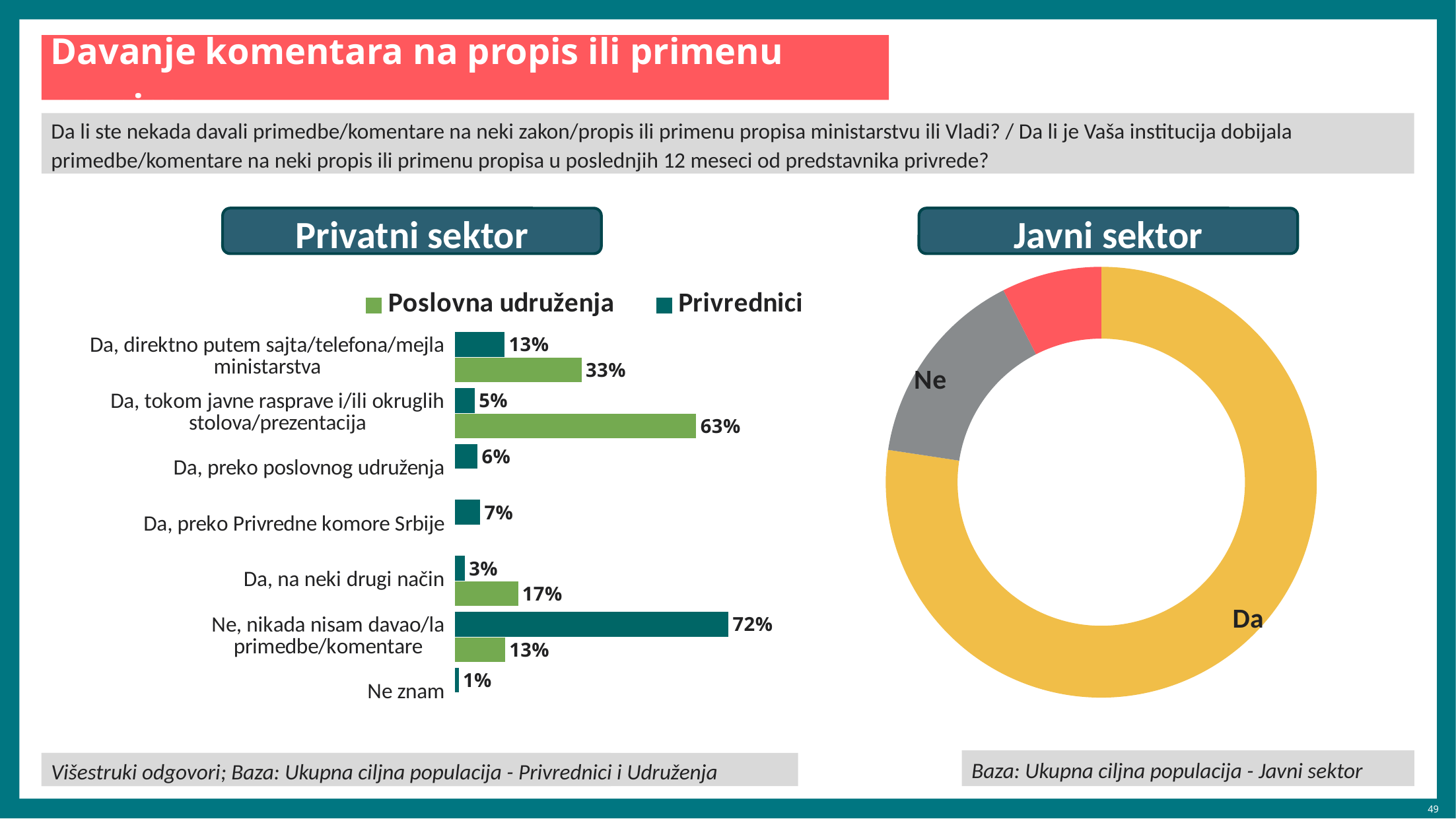
In the 'Privatni sektor' chart, which category has the highest value for Poslovna udruženja? Da, tokom javne rasprave i/ili okruglih stolova/prezentacija How many series does the legend of the 'Privatni sektor' chart list? 2 In the 'Privatni sektor' chart, what is the value for Privrednici for 'Ne, nikada nisam davao/la primedbe/komentare'? 72% What kind of chart is the 'Privatni sektor' chart? Bar chart In the 'Privatni sektor' chart, for 'Da, na neki drugi način', which series has the larger value: Poslovna udruženja or Privrednici? Poslovna udruženja In the 'Privatni sektor' chart, which category has the lowest value for Privrednici? Ne znam In the 'Privatni sektor' chart, what is the value for Poslovna udruženja for 'Da, tokom javne rasprave i/ili okruglih stolova/prezentacija'? 63% In the 'Privatni sektor' chart, what is the value for Privrednici for 'Da, preko Privredne komore Srbije'? 7% In the 'Javni sektor' chart, which labelled slice is the largest? Da What kind of chart is the 'Javni sektor' chart? Donut chart In the 'Privatni sektor' chart, what is the difference between the Poslovna udruženja and Privrednici values for 'Da, direktno putem sajta/telefona/mejla ministarstva'? 20% How many categories are shown in the 'Privatni sektor' chart? 7